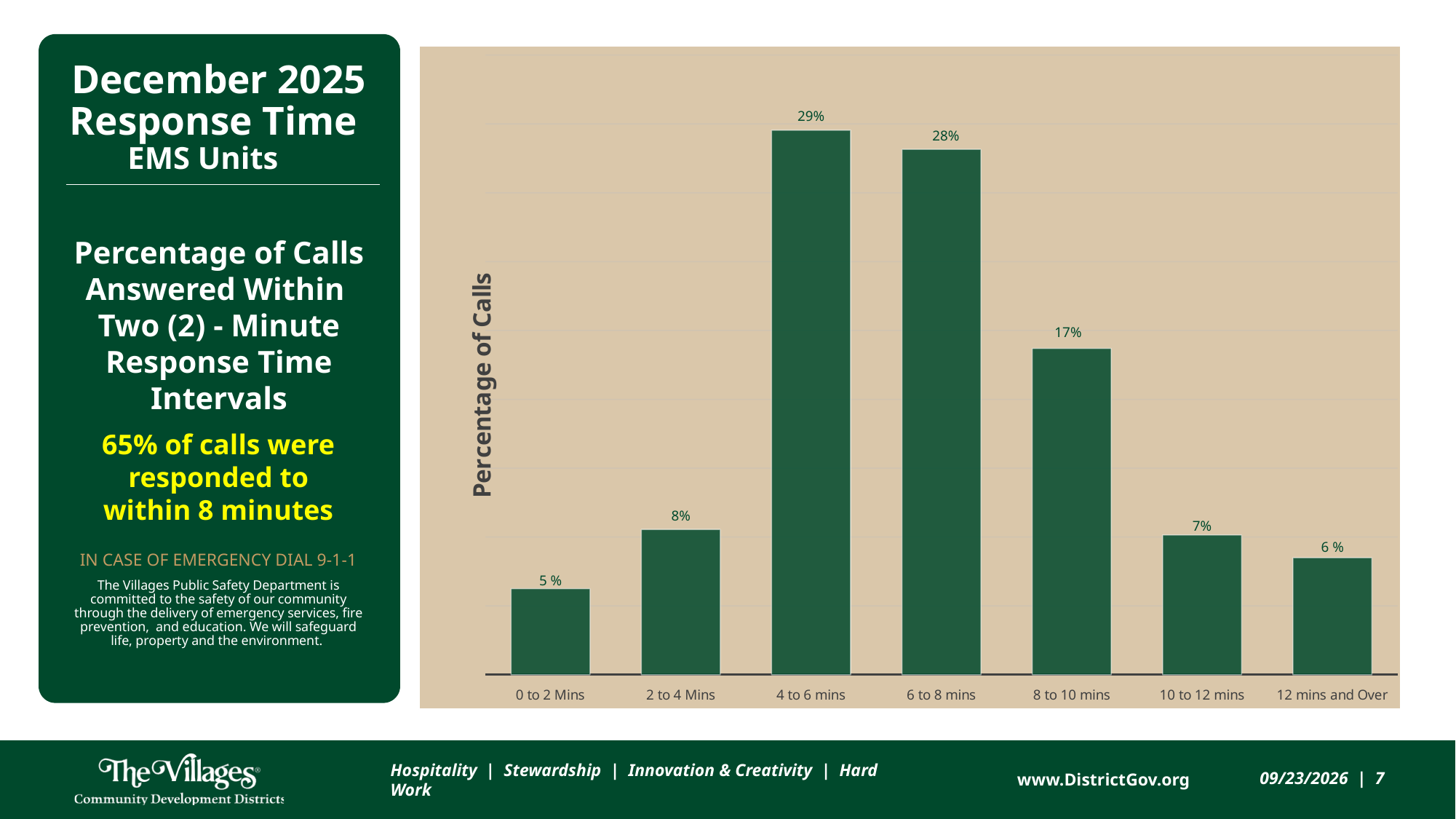
What is the value shown for the 8 to 10 mins interval? 17% Which interval has a larger percentage of calls, 6 to 8 mins or 10 to 12 mins? 6 to 8 mins What is the label of the vertical axis of the chart? Percentage of Calls What percentage of calls were answered in the 4 to 6 mins interval? 29% Which response time interval has the highest percentage of calls? 4 to 6 mins What is the difference between the 2 to 4 Mins value and the 0 to 2 Mins value? 3% What is the difference between the 4 to 6 mins value and the 8 to 10 mins value? 12% Do the values rise or fall from the 6 to 8 mins interval to the 12 mins and Over interval? Fall What percentage of calls fall in the 12 mins and Over interval? 6 % What kind of chart is shown on the slide? Bar chart How many response time intervals are shown on the x axis? 7 Which response time interval has the lowest percentage of calls? 0 to 2 Mins